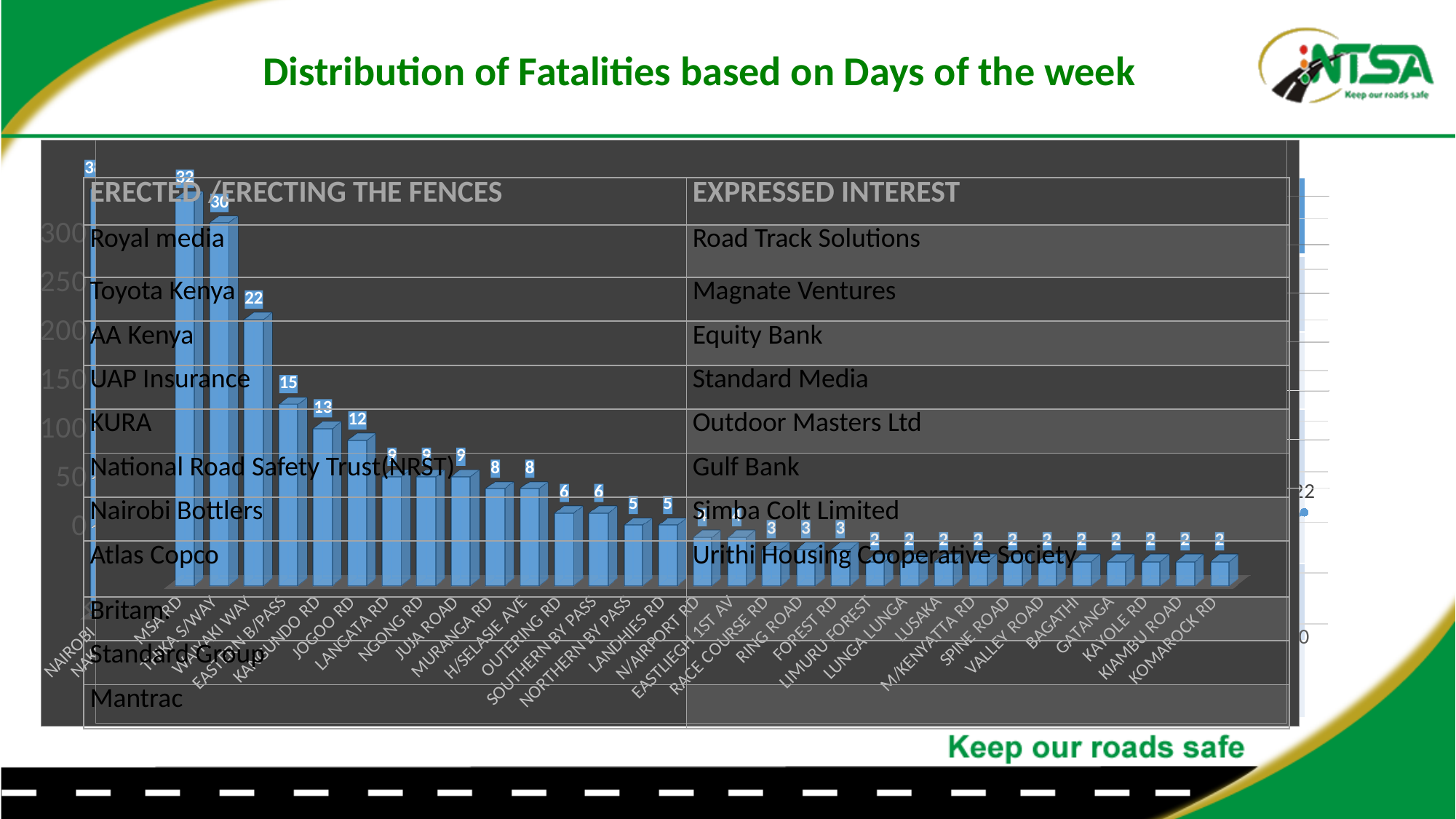
What is the difference between the values for WAIYAKI WAY and EASTERN B/PASS? 7 What kind of chart is shown on the slide? Bar chart What is the value for WAIYAKI WAY? 22 Do the bar values generally rise or fall from left to right along the x axis? Fall What is the difference between the values for MSA RD and THIKA S/WAY? 2 What is the value for THIKA S/WAY? 30 What is the value for KOMAROCK RD? 2 Which has the larger value, KANGUNDO RD or JOGOO RD? KANGUNDO RD What is the value for JOGOO RD? 12 What is the value for EASTERN B/PASS? 15 What is the value for MSA RD? 32 What is the value for KANGUNDO RD? 13